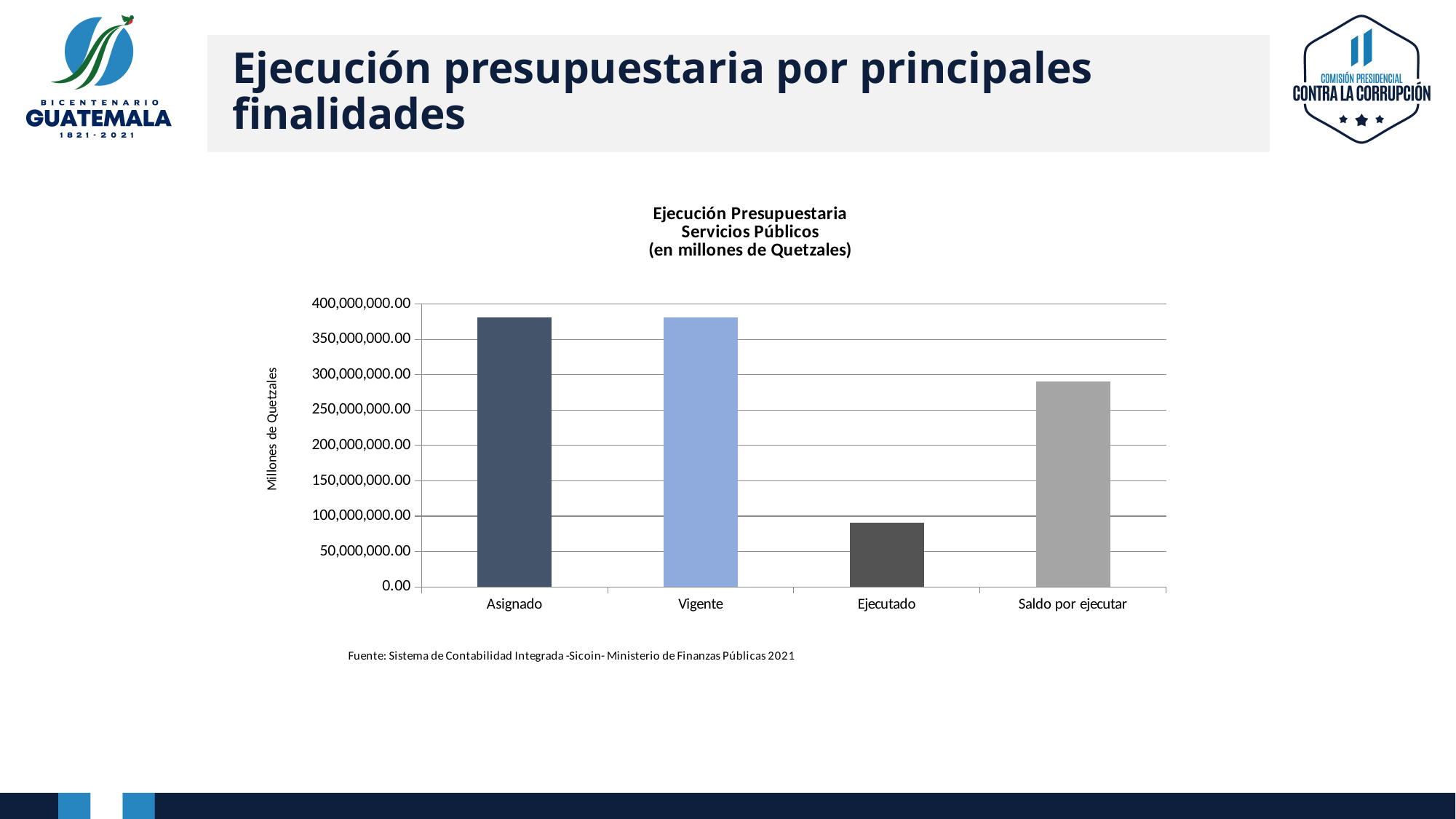
Which is larger, the value for Saldo por ejecutar or the value for Ejecutado? Saldo por ejecutar What kind of chart is shown on the slide? Bar chart Is the value for Asignado greater or less than 350,000,000.00? greater Is the value for Saldo por ejecutar greater or less than 300,000,000.00? less What is the label on the vertical axis of the chart? Millones de Quetzales How many categories are shown on the x axis of the chart? 4 Is the value for Ejecutado greater or less than 100,000,000.00? less What is the title of the chart? Ejecución Presupuestaria Servicios Públicos (en millones de Quetzales) Which is larger, the value for Asignado or the value for Saldo por ejecutar? Asignado Which category has the lowest value in the chart? Ejecutado